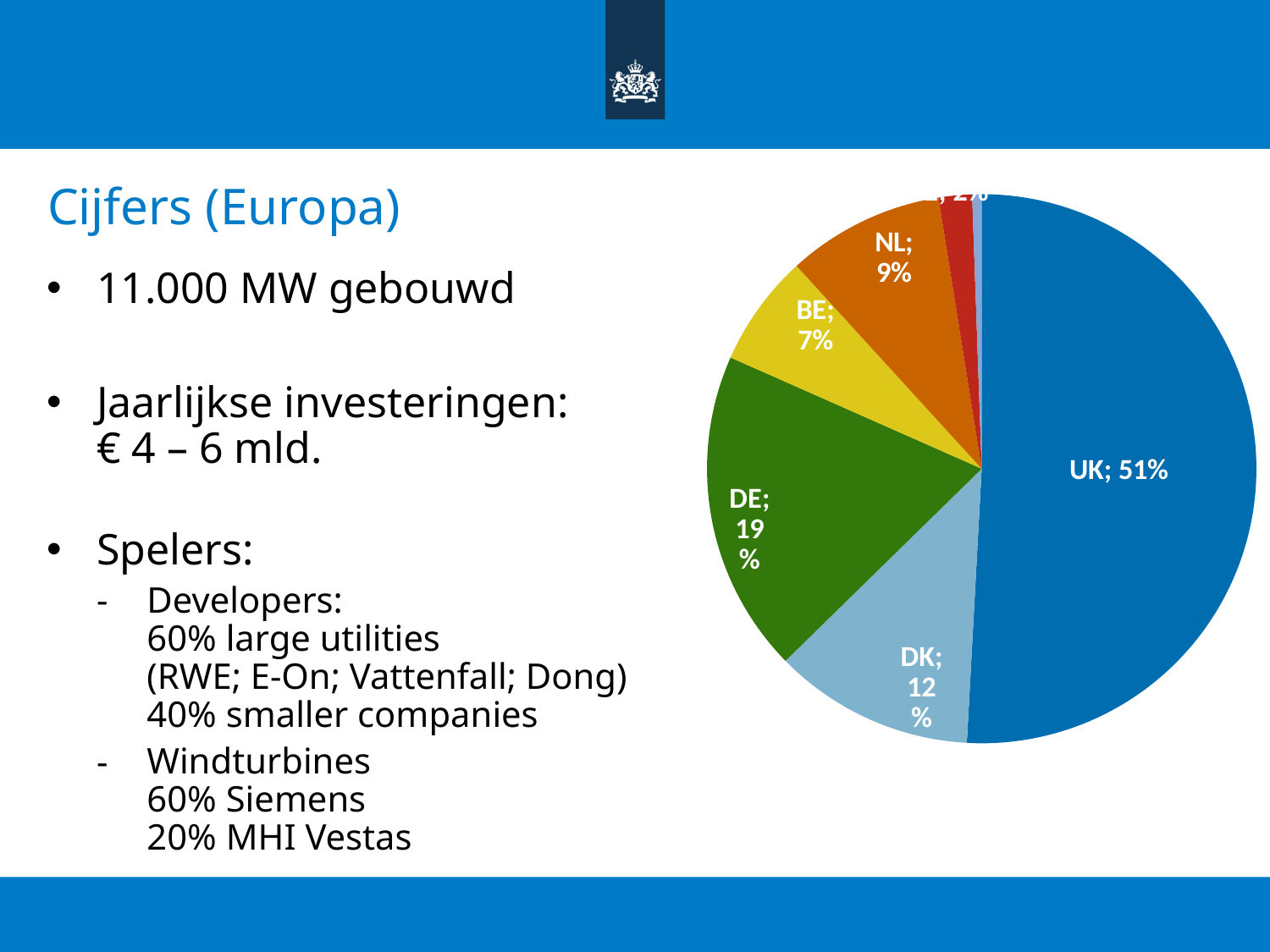
What is the difference in percentage points between DE and DK? 7 What kind of chart is shown on the slide? pie chart What is the difference in percentage points between UK and DE? 32 Which country has the largest slice in the pie chart? UK What percentage is shown for DK in the pie chart? 12% What percentage is shown for BE in the pie chart? 7% What percentage is shown for NL in the pie chart? 9% What share of the pie chart does UK have? 51% Which has a larger share, DK or NL? DK Which has a smaller share, BE or NL? BE Is the value for UK greater or less than 50%? greater What percentage is shown for DE in the pie chart? 19%